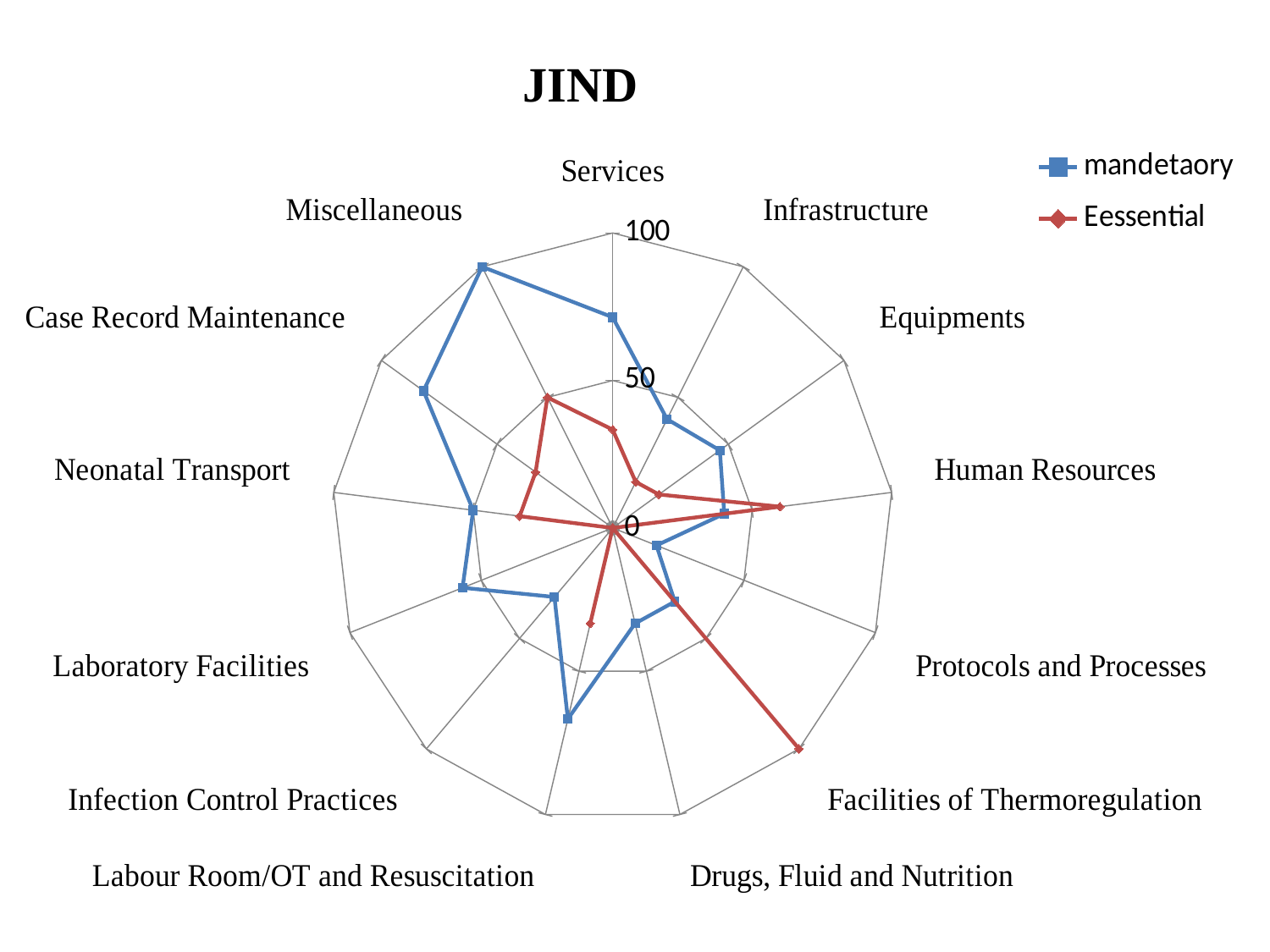
Which category has the highest mandetaory value? Miscellaneous Is the mandetaory value for Miscellaneous greater or less than 50? greater What kind of chart is shown on the slide? Radar chart What is the title of the chart? JIND Is the Eessential value for Facilities of Thermoregulation greater or less than 50? greater Which category has the highest Eessential value? Facilities of Thermoregulation Is the mandetaory value for Human Resources greater or less than 50? less Which series is drawn in red? Eessential How many series does the legend list? 2 How many categories are plotted around the radar chart? 13 For Human Resources, which series has the larger value, mandetaory or Eessential? Eessential